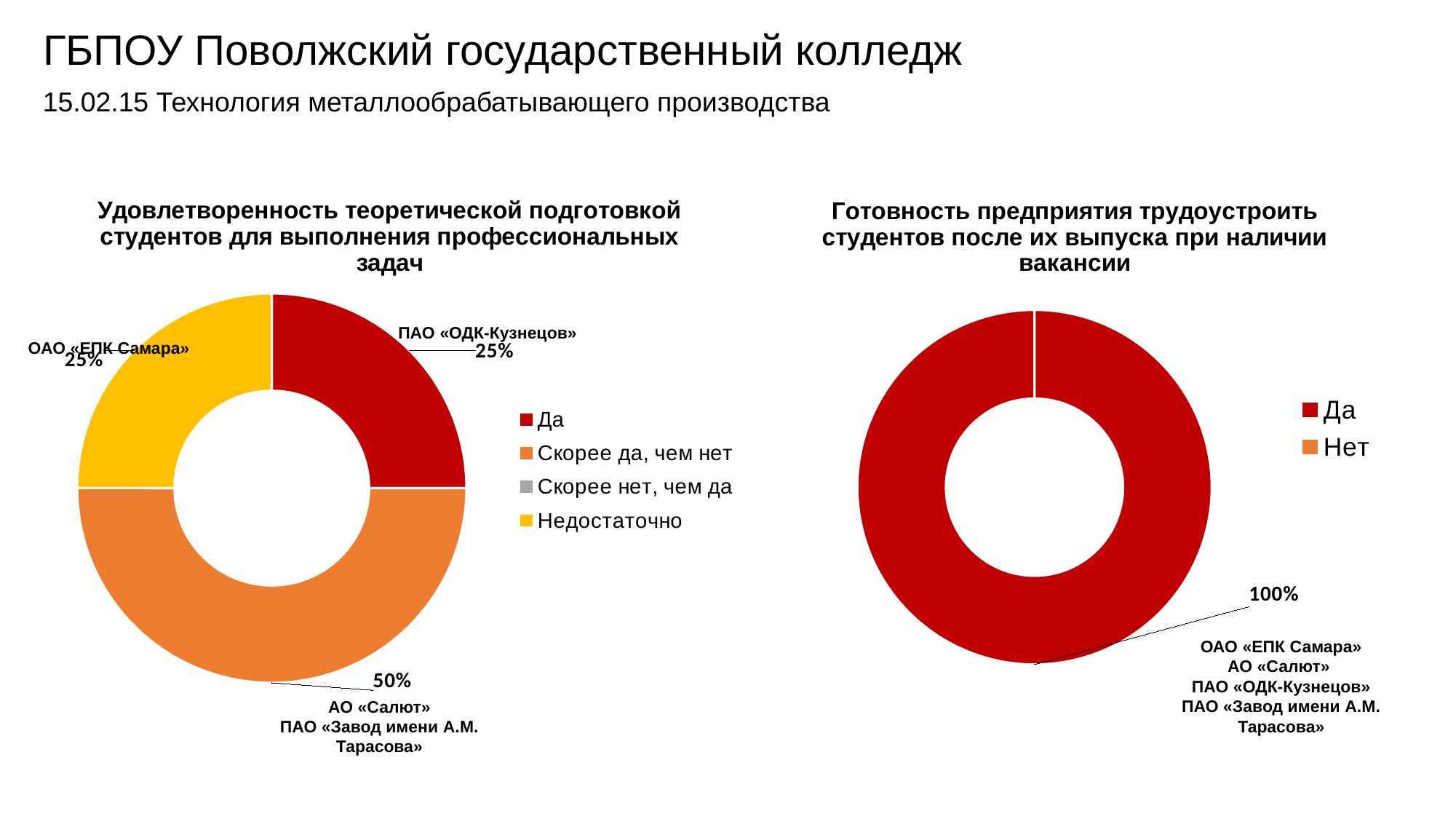
In the right chart (Готовность предприятия трудоустроить студентов...), what share is shown for the 'Да' slice? 100% How many entries does the legend of the right chart (Готовность предприятия трудоустроить студентов...) list? 2 In the left chart (Удовлетворенность теоретической подготовкой...), which response category has the largest slice? Скорее да, чем нет In the left chart (Удовлетворенность теоретической подготовкой...), what share is shown for the 'Да' slice? 25% In the right chart (Готовность предприятия трудоустроить студентов...), what colour is the 'Да' slice? Red How many entries does the legend of the left chart (Удовлетворенность теоретической подготовкой...) list? 4 In the left chart (Удовлетворенность теоретической подготовкой...), what share is shown for the 'Недостаточно' slice? 25% In the left chart (Удовлетворенность теоретической подготовкой...), what is the difference between the 'Скорее да, чем нет' slice and the 'Да' slice? 25% In the left chart (Удовлетворенность теоретической подготовкой...), which is larger: the 'Скорее да, чем нет' slice or the 'Недостаточно' slice? Скорее да, чем нет What kind of chart is the right chart (Готовность предприятия трудоустроить студентов...)? Doughnut (pie) chart In the left chart (Удовлетворенность теоретической подготовкой...), what share is shown for the 'Скорее да, чем нет' slice? 50% In the left chart (Удовлетворенность теоретической подготовкой...), which enterprise is labelled next to the 'Недостаточно' slice? ОАО «ЕПК Самара»